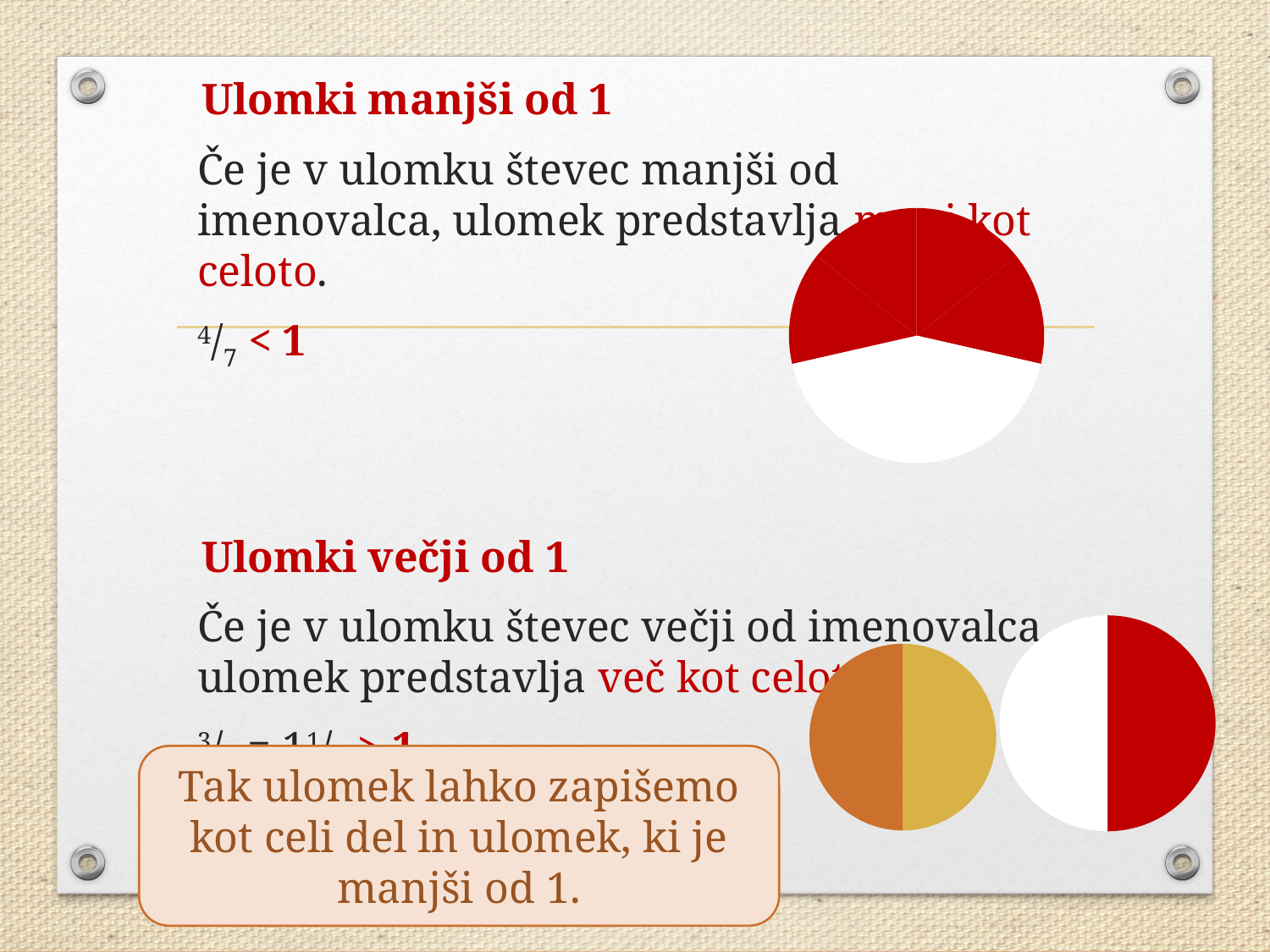
What colour is the shaded portion of the upper-right pie chart? red In the upper-right pie chart, which is larger, the red portion or the white portion? red What kind of charts are shown at the bottom right of the slide? pie charts What two colours are used in the bottom-left pie chart? orange and yellow How many slices does the bottom-left pie chart (orange and yellow) have? 2 What kind of chart is shown in the upper right of the slide? pie chart How many slices does the bottom-right pie chart (red and white) have? 2 How many pie charts are on the slide in total? 3